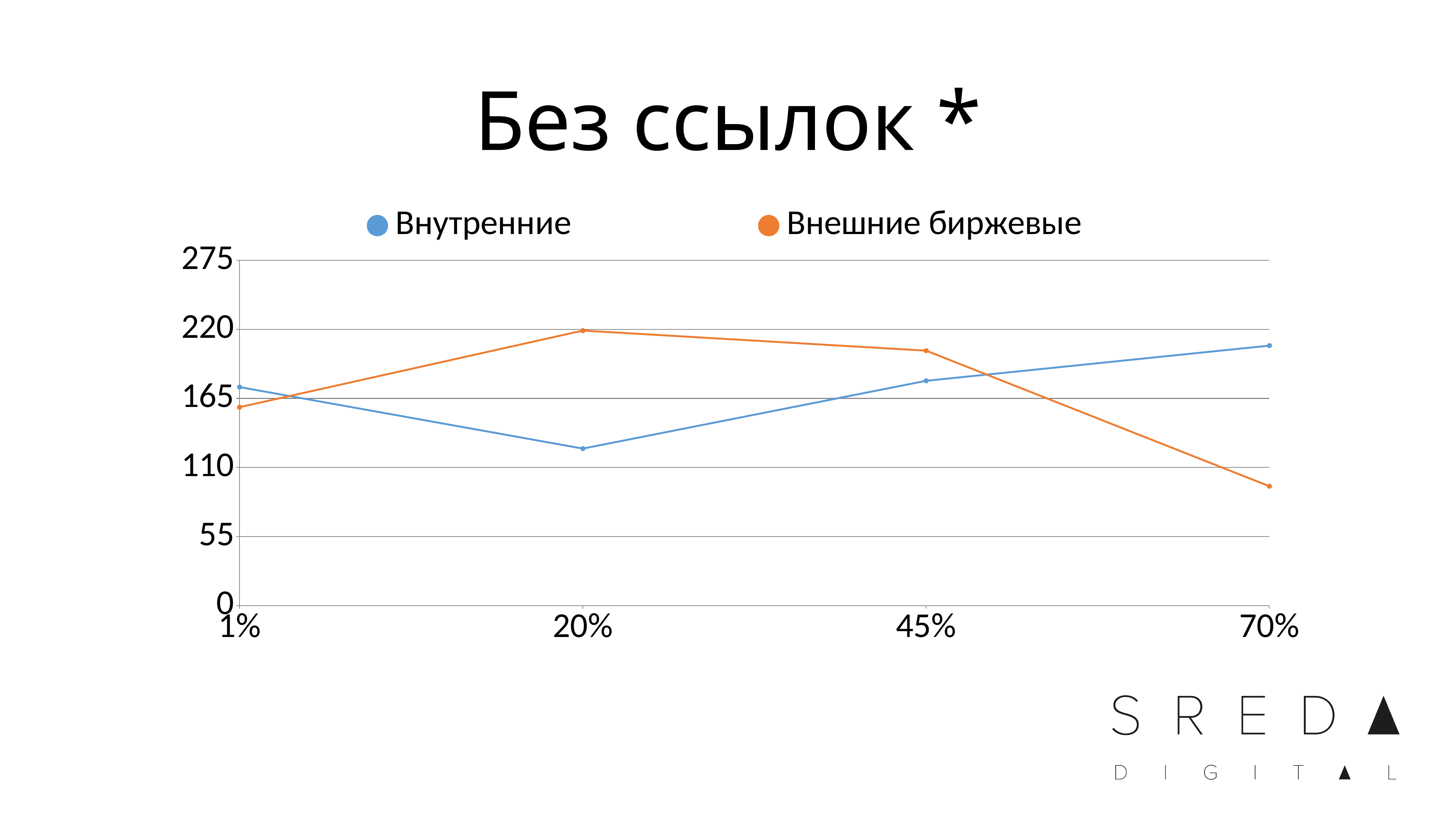
At which x-axis category does the Внешние биржевые series reach its lowest value? 70% Is the value for Внутренние at 20% greater or less than 165? less What is the title of the chart? Без ссылок * At which x-axis category does the Внутренние series reach its highest value? 70% How many points are plotted along the x axis for each series? 4 At which x-axis category does the Внешние биржевые series reach its highest value? 20% At 70%, which series has the larger value, Внутренние or Внешние биржевые? Внутренние At which x-axis category does the Внутренние series reach its lowest value? 20% What kind of chart is shown on the slide? line chart Is the value for Внешние биржевые at 70% greater or less than 110? less How many series does the legend list? 2 Which series is drawn in orange? Внешние биржевые